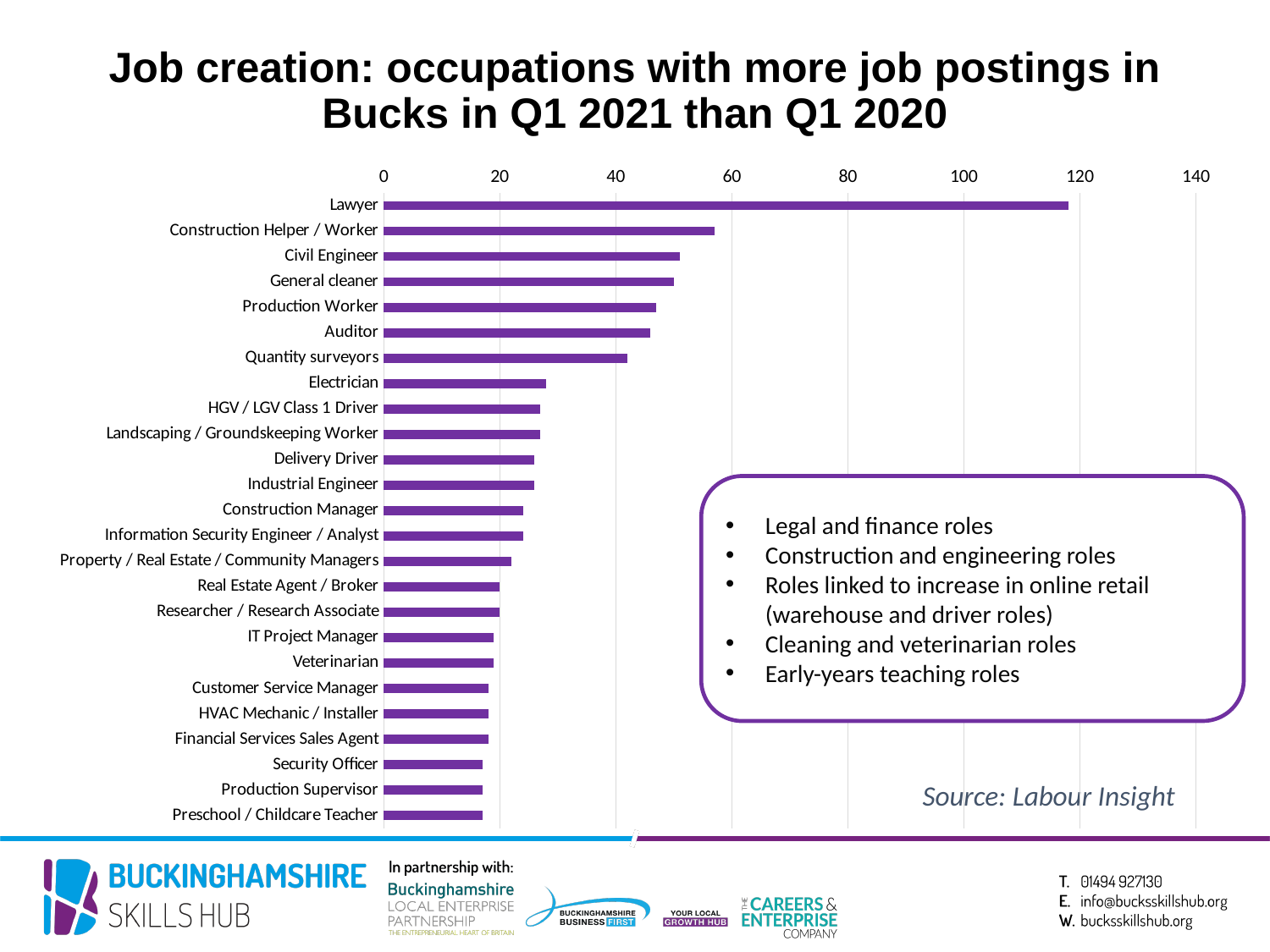
Is the value for Construction Helper / Worker greater or less than 60? less Is the value for Preschool / Childcare Teacher greater or less than 20? less What source is cited for the chart data? Labour Insight Which has a larger value, Lawyer or Civil Engineer? Lawyer Which occupation has the highest value in the chart? Lawyer Is the value for Lawyer greater or less than 100? greater How many occupations are listed in the chart? 25 Do the bar values increase or decrease going from the top of the chart to the bottom? decrease What kind of chart is shown on the slide? bar chart Which has a larger value, Construction Helper / Worker or Electrician? Construction Helper / Worker